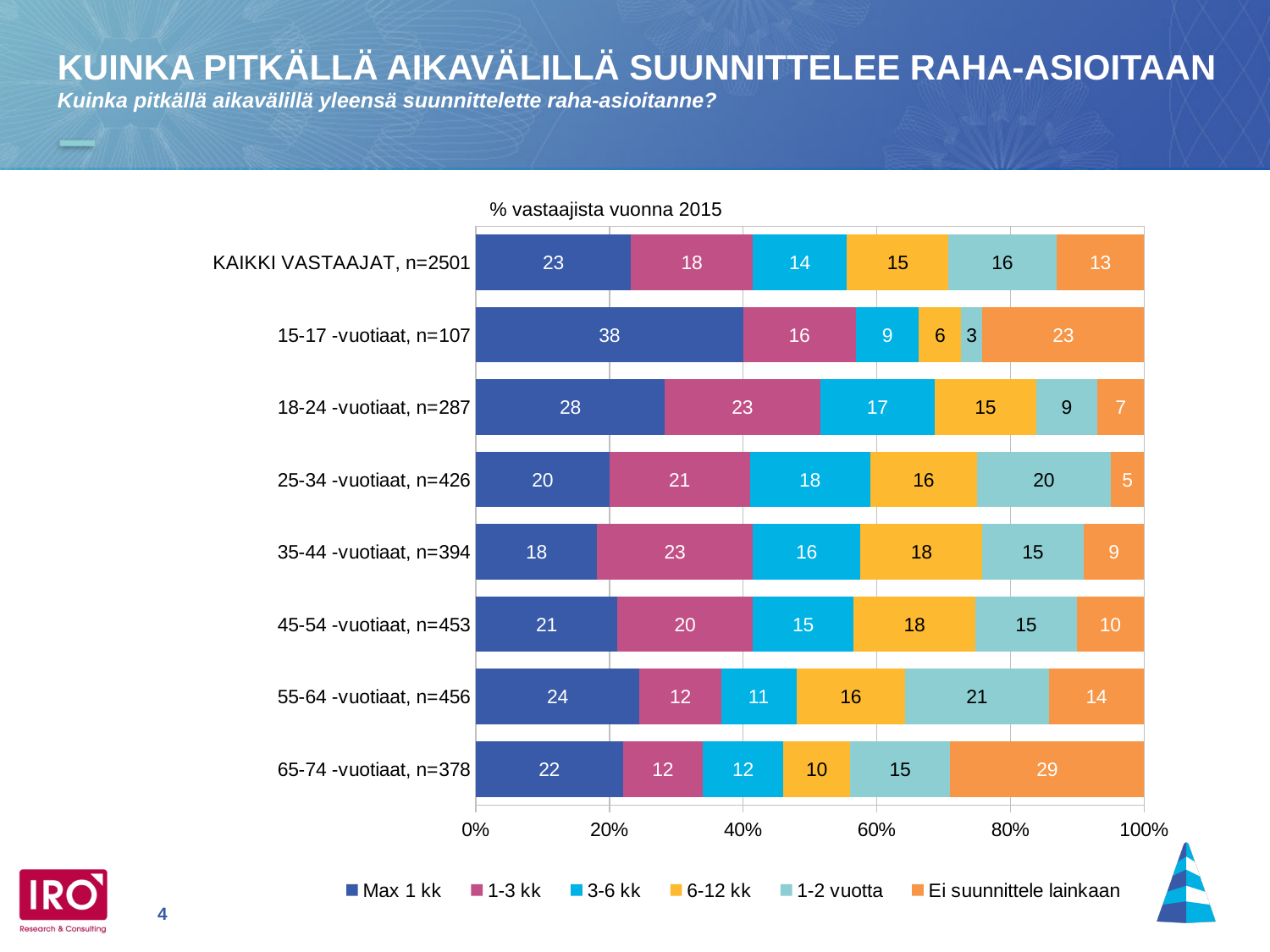
What is the difference between the 'Max 1 kk' values for '15-17 -vuotiaat, n=107' and '18-24 -vuotiaat, n=287'? 10 What is the value for '1-2 vuotta' in the '55-64 -vuotiaat, n=456' category? 21 What is the value for 'Max 1 kk' in the '15-17 -vuotiaat, n=107' category? 38 How many categories are shown on the chart? 8 How many series does the legend list? 6 Which is larger: the '1-3 kk' value for '35-44 -vuotiaat, n=394' or for '55-64 -vuotiaat, n=456'? 35-44 -vuotiaat, n=394 What is the total of the stacked bar for '65-74 -vuotiaat, n=378'? 100 What is the title shown above the chart? % vastaajista vuonna 2015 Which category has the highest value for 'Max 1 kk'? 15-17 -vuotiaat, n=107 What kind of chart is shown on the slide? Stacked bar chart Which category has the lowest value for 'Ei suunnittele lainkaan'? 25-34 -vuotiaat, n=426 What is the value for 'Ei suunnittele lainkaan' in the '65-74 -vuotiaat, n=378' category? 29